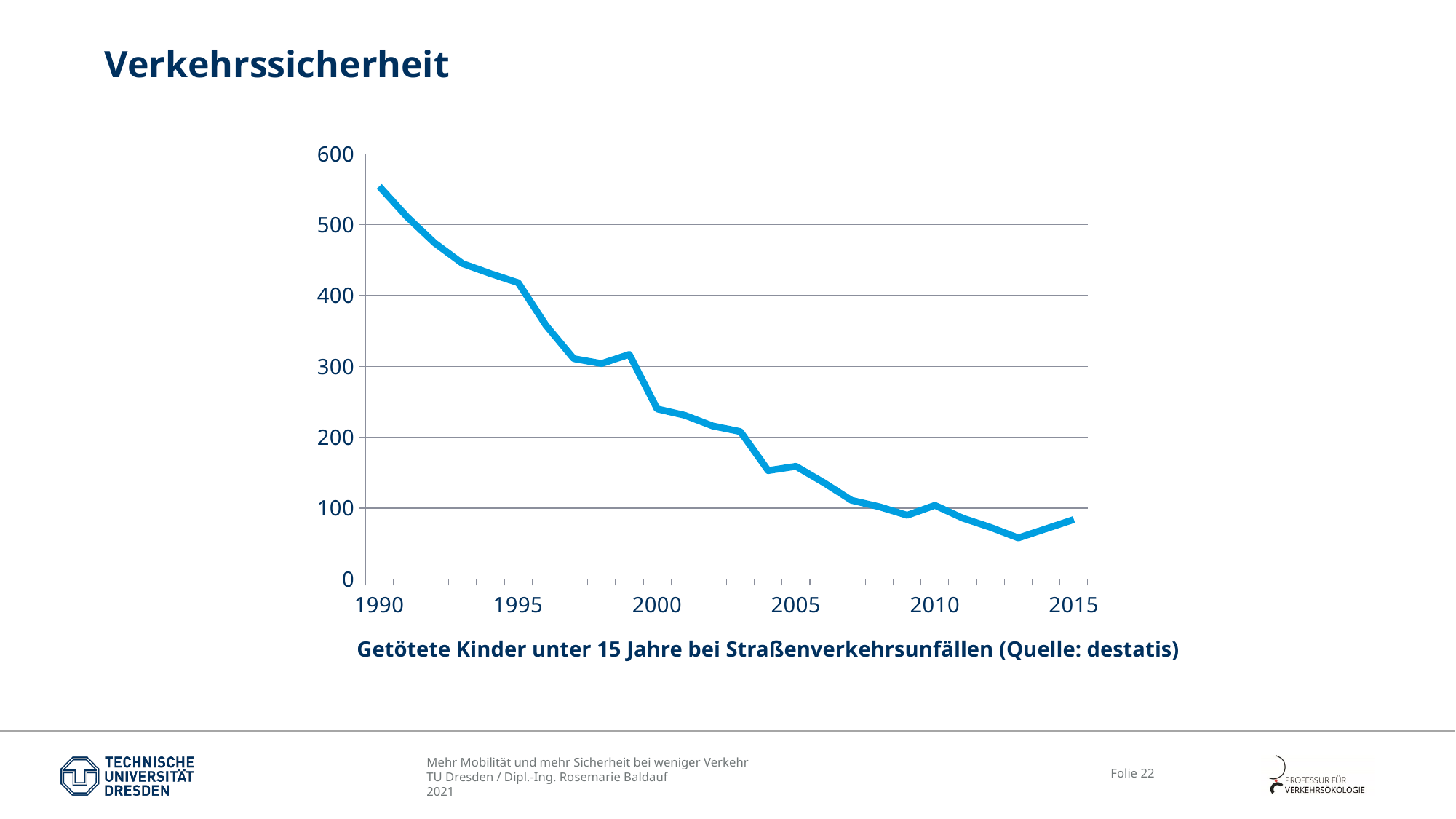
What is the caption below the chart? Getötete Kinder unter 15 Jahre bei Straßenverkehrsunfällen (Quelle: destatis) Is the value for 2000 greater or less than 200? greater Is the value for 2005 greater or less than 200? less Do the values generally rise or fall from 1990 to 2015? fall Is the value for 2015 greater or less than 100? less What kind of chart is shown on the slide? line chart Which year has the larger value, 1990 or 2015? 1990 What source is given for the chart data? destatis Which year has the lowest value? 2013 Which year has the highest value? 1990